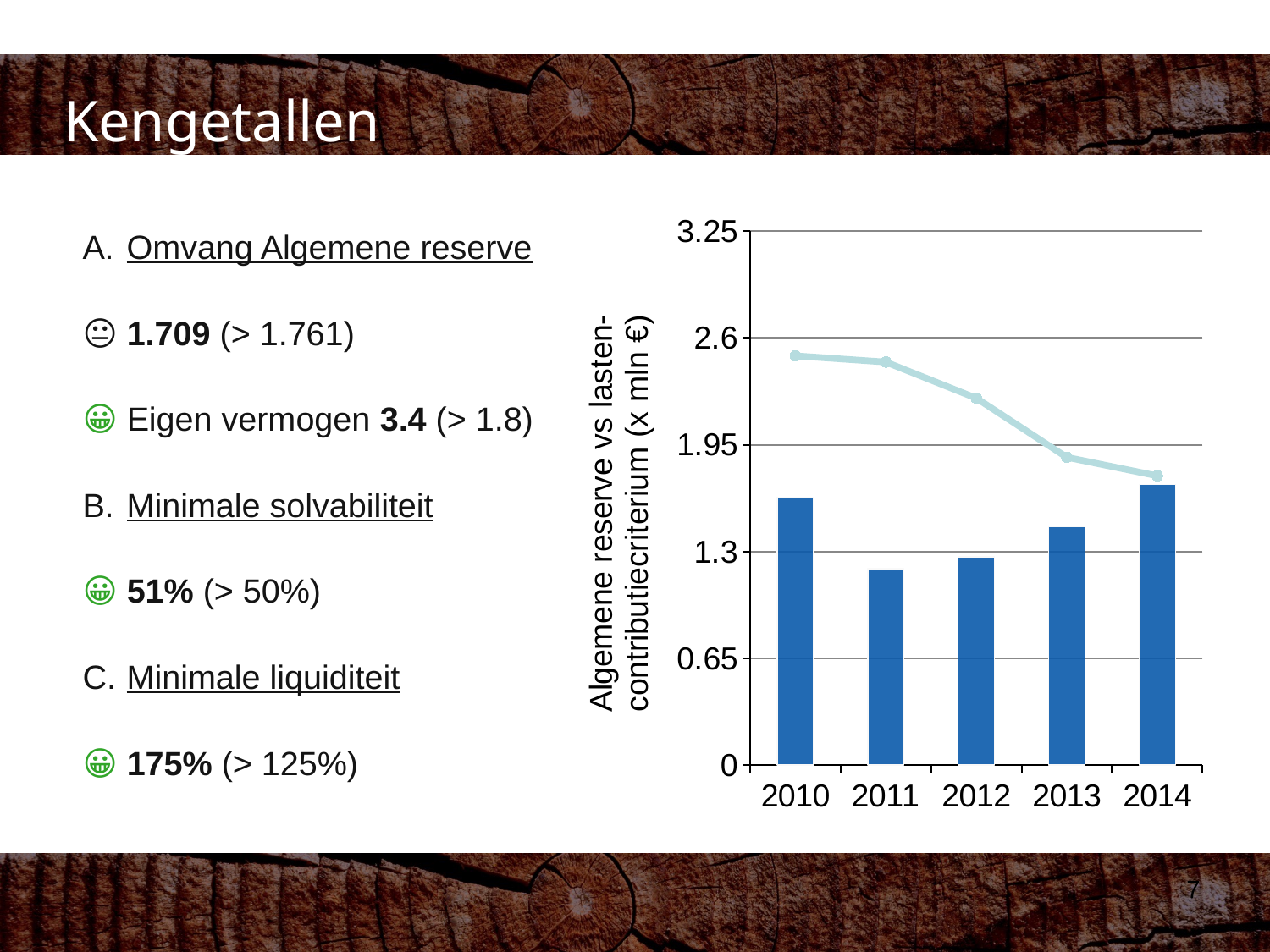
Which year has the shortest bar in the chart? 2011 Is the bar for 2010 greater or less than 1.3? greater What kind of chart is shown on the slide? A bar chart combined with a line Is the bar for 2014 greater or less than 1.95? less Which bar is taller, 2010 or 2011? 2010 Is the line value for 2010 greater or less than 2.6? less Does the line series rise or fall from 2010 to 2014? It falls Which year has the tallest bar in the chart? 2014 What is the label on the vertical axis of the chart? Algemene reserve vs lasten-contributiecriterium (x mln €) How many years are shown on the x axis of the chart? 5